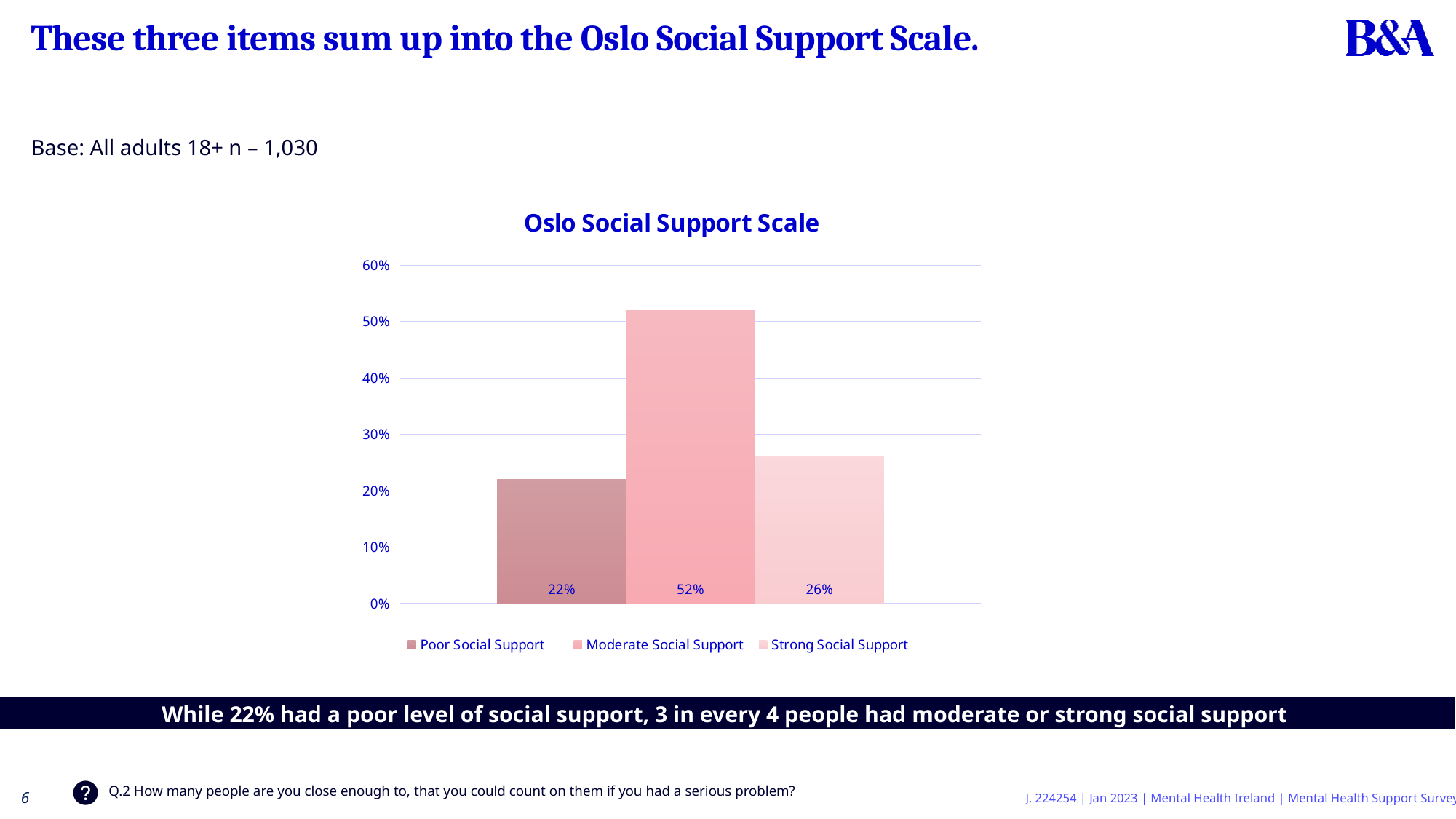
Which social support category has the highest percentage? Moderate Social Support Which is larger, the percentage for Strong Social Support or for Poor Social Support? Strong Social Support What is the difference in percentage points between Moderate Social Support and Strong Social Support? 26 Is the value for Moderate Social Support greater or less than 50%? greater What is the title of the chart on the slide? Oslo Social Support Scale What type of chart is used to show the Oslo Social Support Scale? Bar chart How many social support categories are plotted in the chart? 3 What percentage of adults had Strong Social Support? 26% What percentage of adults had Moderate Social Support on the Oslo Social Support Scale? 52% How many entries does the chart legend list? 3 Which social support category has the lowest percentage? Poor Social Support What percentage of adults had Poor Social Support? 22%